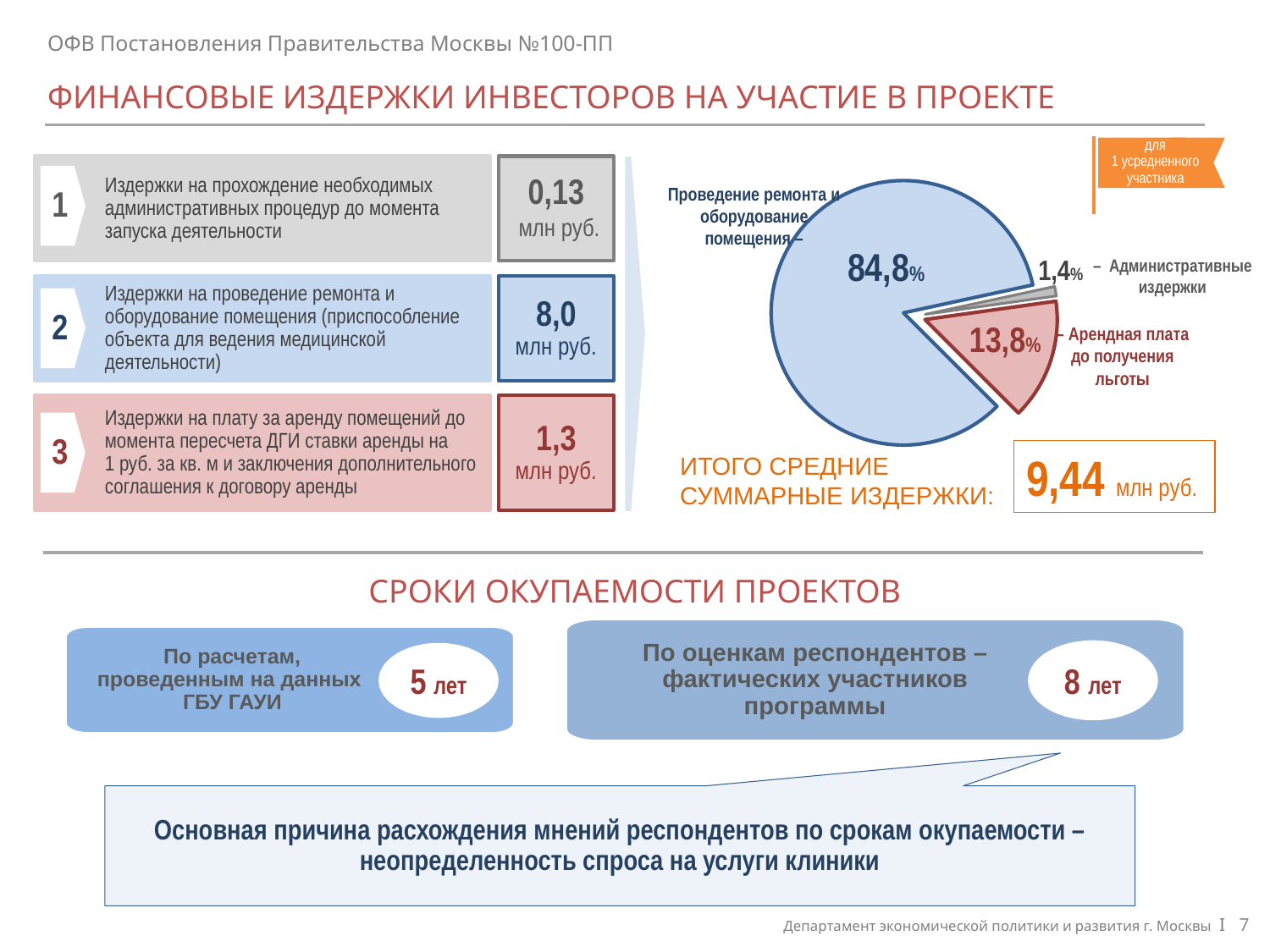
What colour is the largest slice of the pie chart? Light blue What share of the pie chart is labelled "Проведение ремонта и оборудование помещения"? 84,8% How many slices does the pie chart have? 3 What is the value shown for "Административные издержки" in the pie chart? 1,4% Which slice of the pie chart is the smallest? Административные издержки What is the value shown for "Арендная плата до получения льготы" in the pie chart? 13,8% What kind of chart is shown on the slide? Pie chart In the pie chart, which is larger: "Арендная плата до получения льготы" or "Административные издержки"? Арендная плата до получения льготы What colour is the "Арендная плата до получения льготы" slice of the pie chart? Pink (red outline) What is the difference in percentage points between the "Проведение ремонта и оборудование помещения" slice and the "Арендная плата до получения льготы" slice? 71,0 Which slice of the pie chart is the largest? Проведение ремонта и оборудование помещения What is the difference in percentage points between the "Арендная плата до получения льготы" slice and the "Административные издержки" slice? 12,4